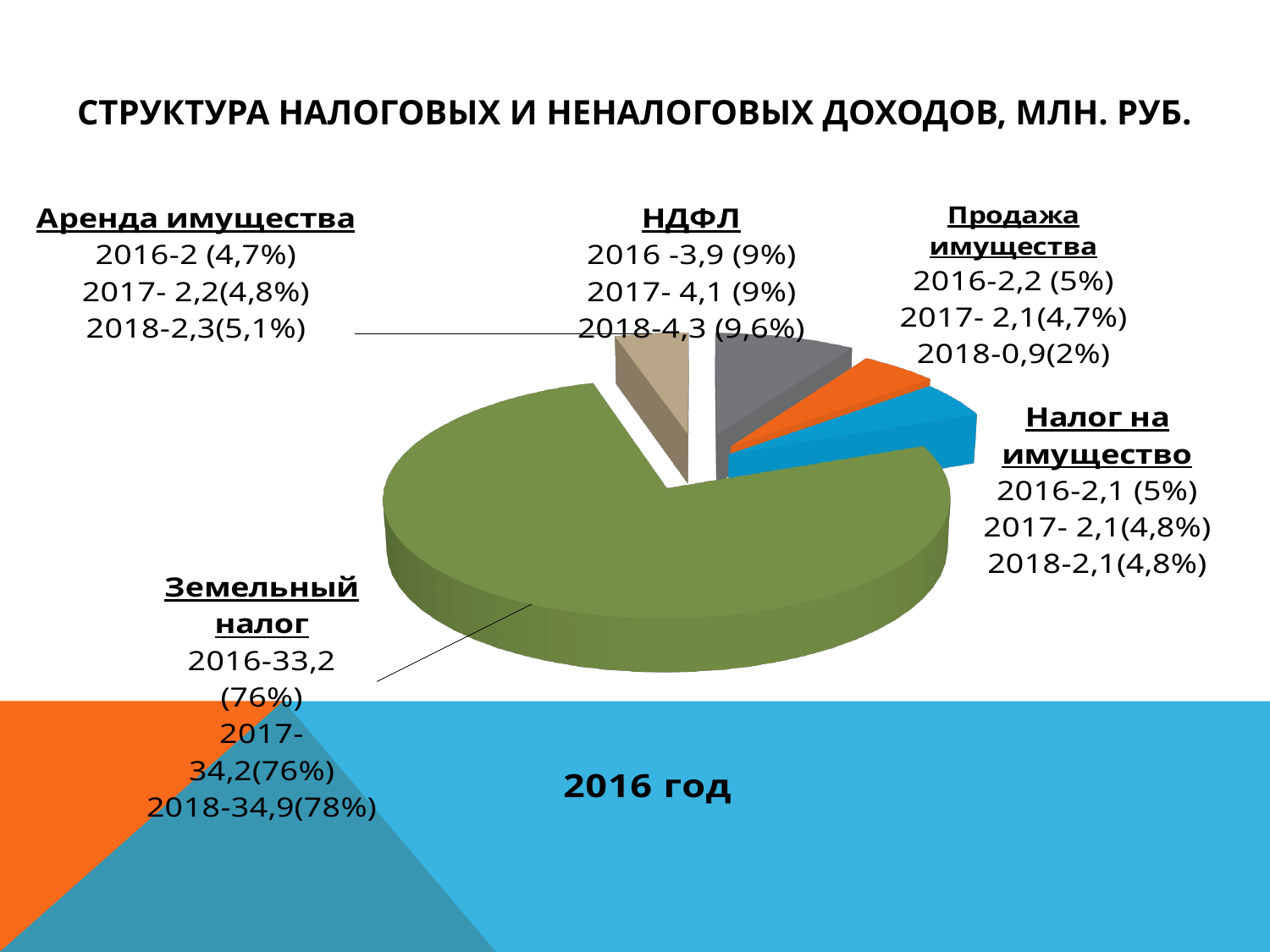
What is the 2016 value for Продажа имущества? 2,2 What kind of chart is shown on the slide? Pie chart Which category has the largest slice of the pie chart? Земельный налог How many slices does the pie chart have? 5 What is the 2016 value for Земельный налог? 33,2 What share of the pie does НДФЛ have in 2016? 9% What is the 2016 value for НДФЛ? 3,9 Which year does the pie chart represent? 2016 год Which is larger in 2016: НДФЛ or Налог на имущество? НДФЛ What is the difference between the 2016 values for Земельный налог and НДФЛ? 29,3 What share of the pie does Земельный налог have in 2016? 76% What is the 2016 value for Аренда имущества? 2